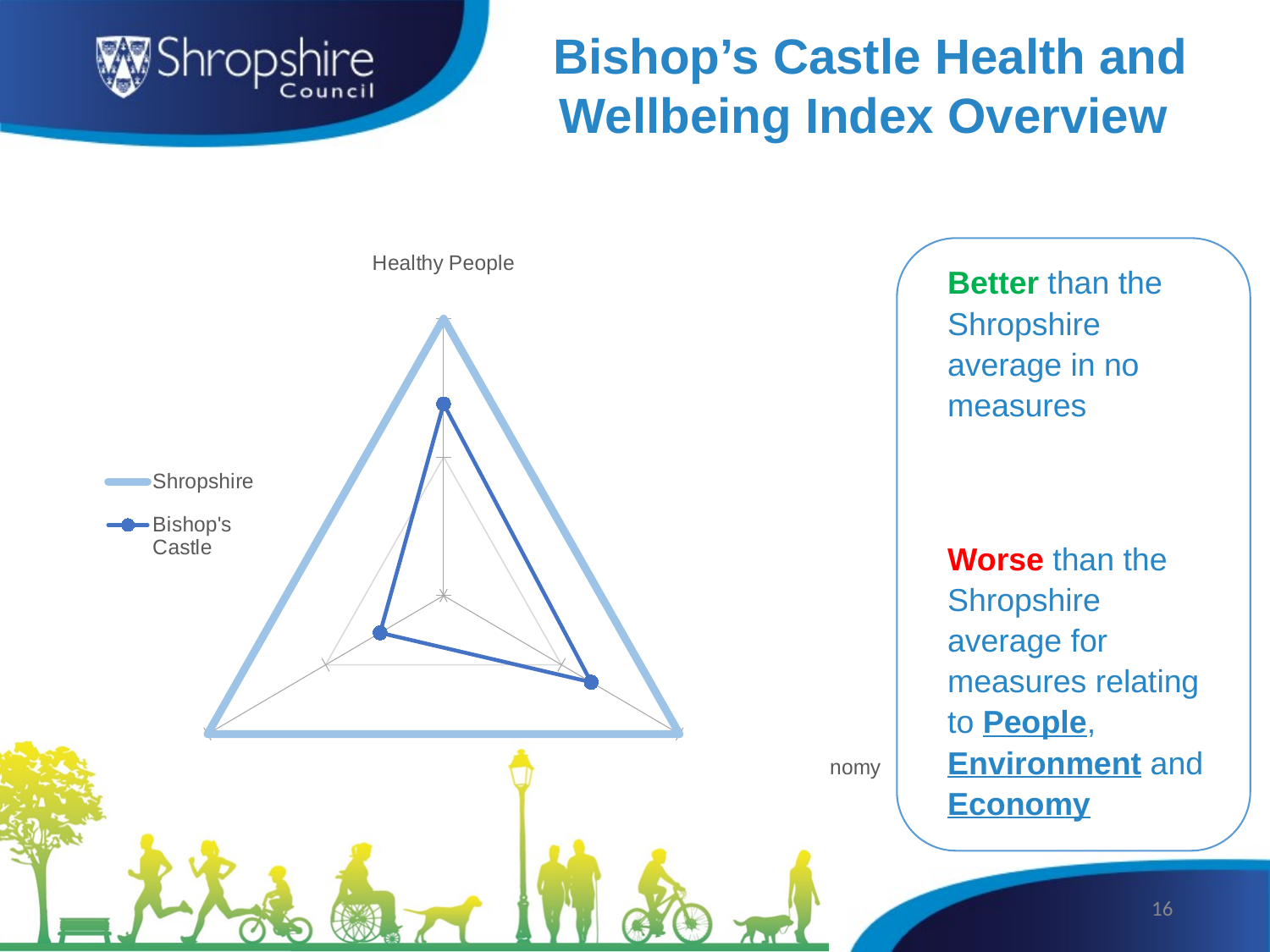
On the Healthy People axis, which series has the larger value, Shropshire or Bishop's Castle? Shropshire How many series does the chart legend list? 2 Which two series are listed in the chart legend? Shropshire and Bishop's Castle What kind of chart is shown on the slide? Radar chart How many axes (categories) does the radar chart have? 3 Which series is drawn with the darker blue line with circular markers? Bishop's Castle Which axis label appears at the top of the radar chart? Healthy People